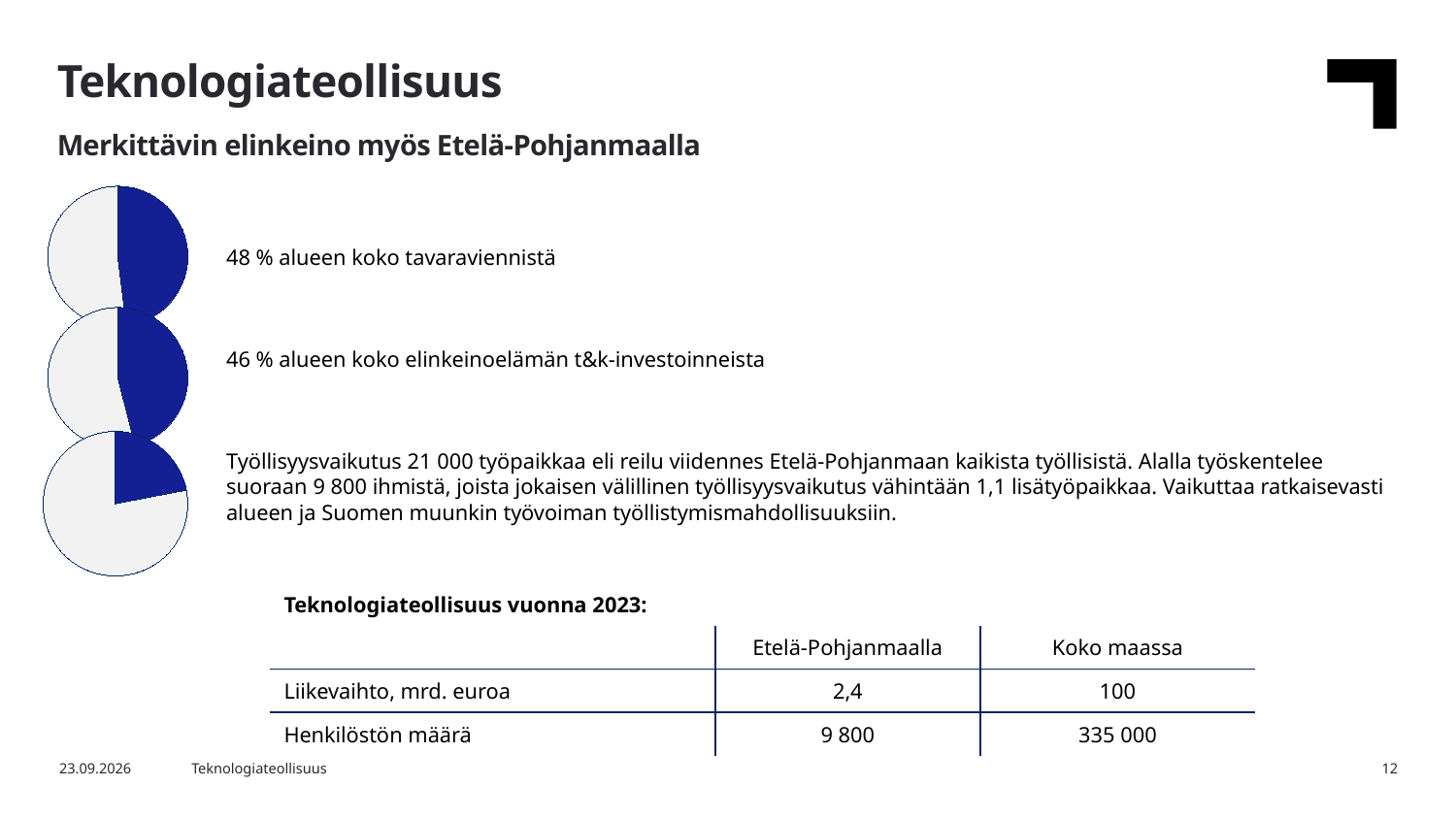
In the top pie chart, what share does the blue slice represent (share of the region's total goods exports)? 48 % Which pie chart has the largest blue slice: the top, middle or bottom one? top How many pie charts are shown on the slide? 3 Is the blue slice of the bottom pie chart more or less than half of the pie? less Which pie chart has the smallest blue slice: the top, middle or bottom one? bottom What kind of chart is the top chart on the left of the slide? pie chart What does the top pie chart illustrate, according to the text next to it? 48 % alueen koko tavaraviennistä In the middle pie chart, what share does the blue slice represent (share of the region's business R&D investments)? 46 % How many slices does each pie chart have? 2 What is the difference in percentage points between the blue slice of the top pie chart (48 %) and the blue slice of the middle pie chart (46 %)? 2 percentage points Is the blue slice of the top pie chart larger or smaller than the blue slice of the bottom pie chart? larger What colour is the highlighted slice in the pie charts? blue